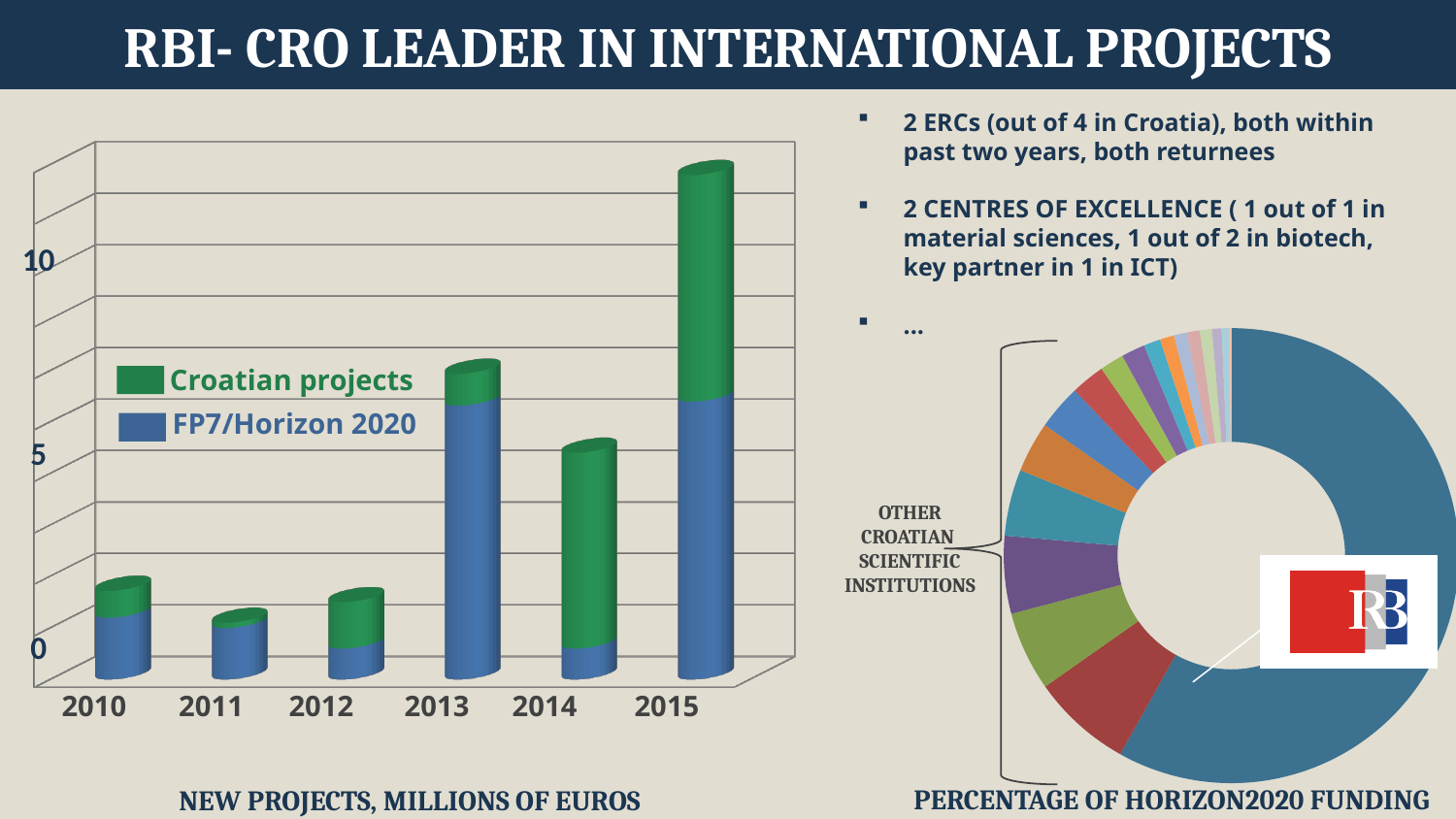
In the NEW PROJECTS, MILLIONS OF EUROS chart, how many years are shown on the x axis? 6 What kind of chart is the chart titled PERCENTAGE OF HORIZON2020 FUNDING? doughnut chart What kind of chart is the chart titled NEW PROJECTS, MILLIONS OF EUROS? bar chart In the NEW PROJECTS, MILLIONS OF EUROS chart, which year has the highest total bar? 2015 In the NEW PROJECTS, MILLIONS OF EUROS chart, is the total for 2015 greater or less than 10? greater In the NEW PROJECTS, MILLIONS OF EUROS chart, which series is shown in blue? FP7/Horizon 2020 In the NEW PROJECTS, MILLIONS OF EUROS chart, is the total for 2010 greater or less than 5? less In the NEW PROJECTS, MILLIONS OF EUROS chart, which year has the larger total bar, 2013 or 2014? 2013 In the NEW PROJECTS, MILLIONS OF EUROS chart, which year has the lowest total bar? 2011 In the NEW PROJECTS, MILLIONS OF EUROS chart, is the total for 2013 greater or less than 5? greater In the NEW PROJECTS, MILLIONS OF EUROS chart, how many series does the legend list? 2 In the NEW PROJECTS, MILLIONS OF EUROS chart, does the total rise or fall from 2014 to 2015? rise